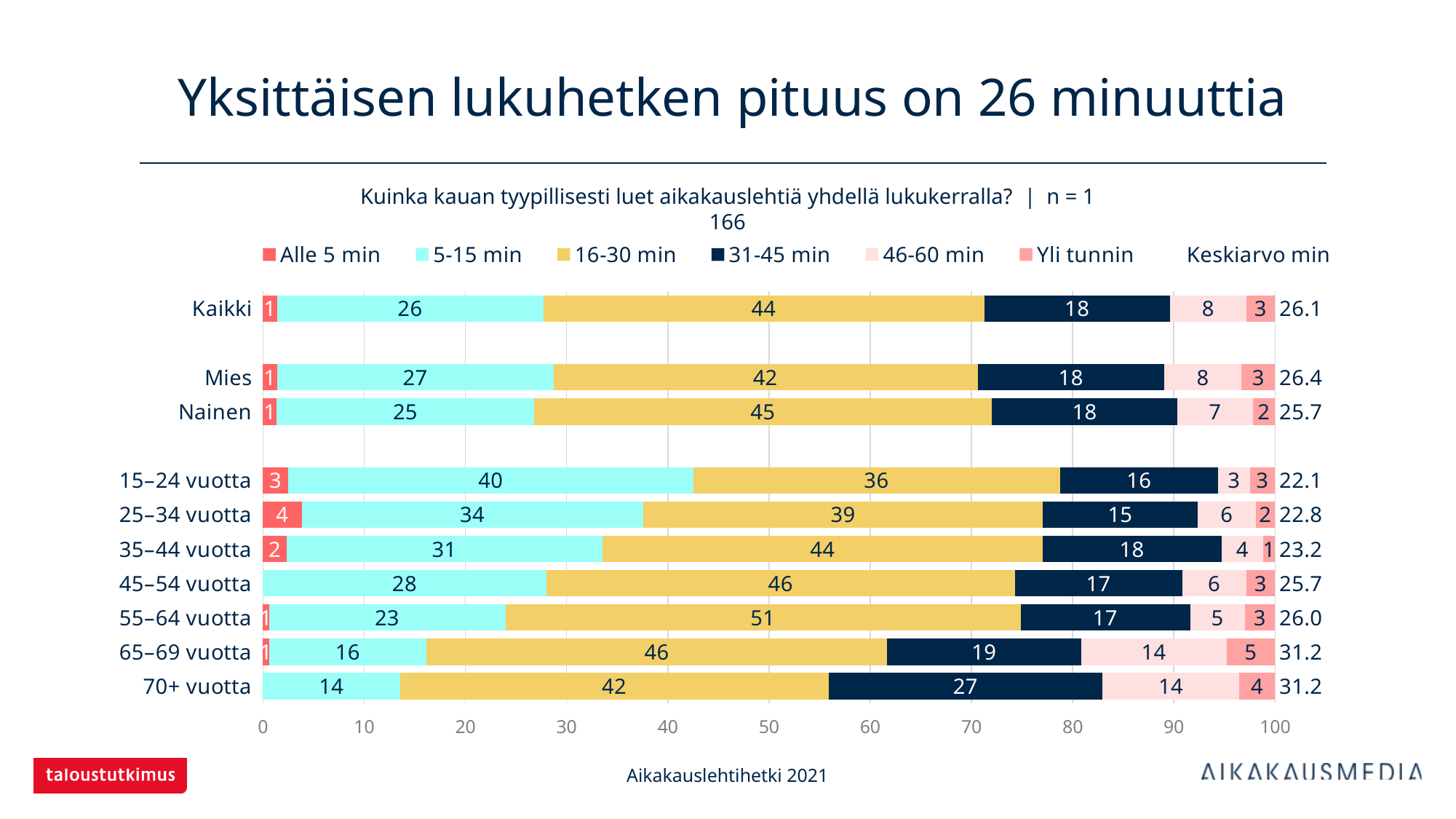
What is the value of the 16-30 min segment for 55–64 vuotta? 51 What kind of chart is shown on the slide? Stacked bar chart Which category has the highest value in the 31-45 min segment? 70+ vuotta Which has the larger 46-60 min value, 65–69 vuotta or 55–64 vuotta? 65–69 vuotta Which category has the lowest Keskiarvo min value? 15–24 vuotta What is the value of the 31-45 min segment for Kaikki? 18 What is the difference between the 16-30 min values for Nainen and Mies? 3 What is the Keskiarvo min value shown for 65–69 vuotta? 31.2 How many categories (rows) are plotted in the chart? 10 Which category has the highest value in the 5-15 min segment? 15–24 vuotta What is the value of the Alle 5 min segment for 25–34 vuotta? 4 Which category has the lowest value in the 5-15 min segment? 70+ vuotta